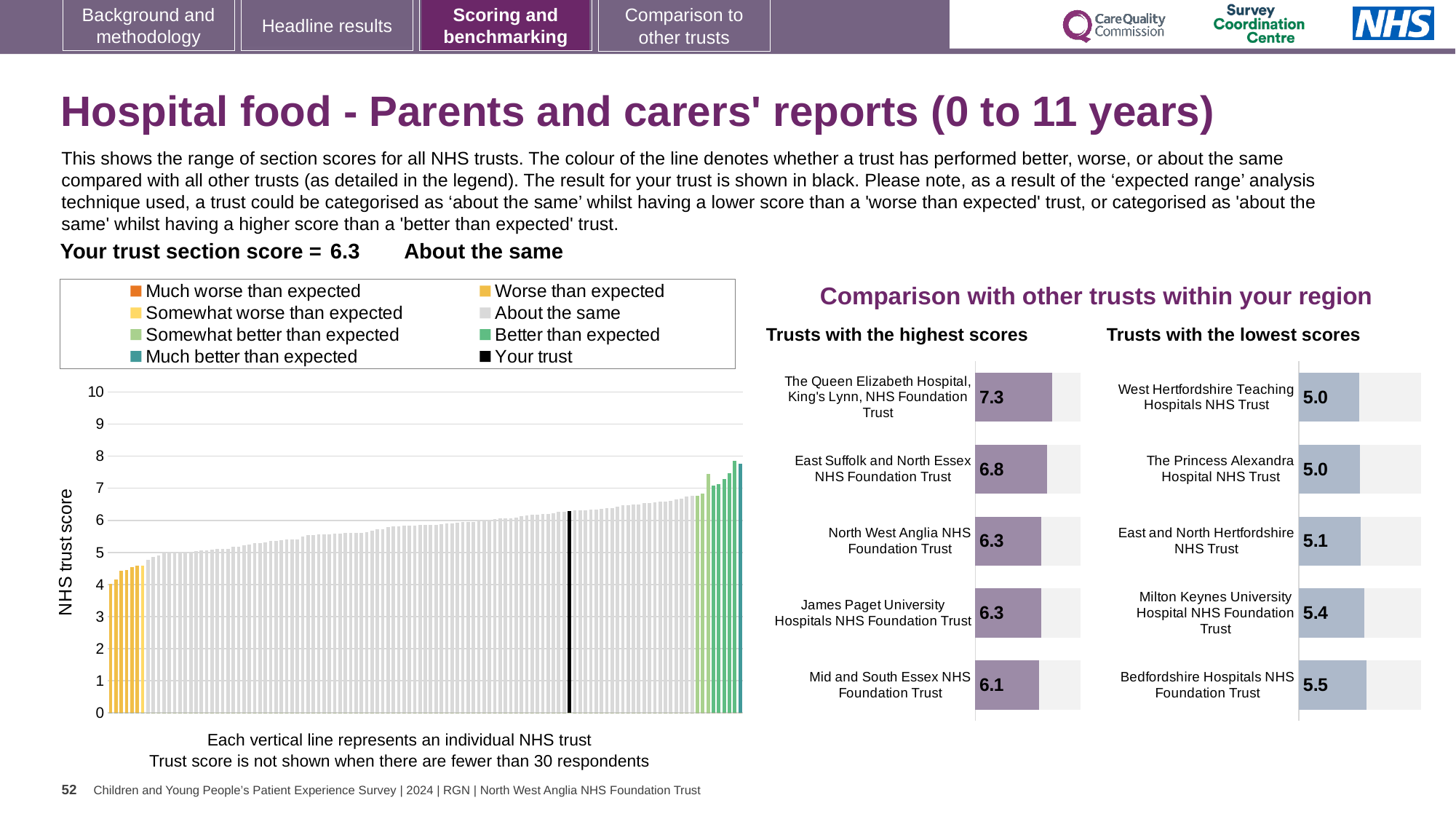
In the 'Trusts with the highest scores' chart, which trust has the lowest score? Mid and South Essex NHS Foundation Trust In the 'Trusts with the highest scores' chart, what is the difference between the scores of The Queen Elizabeth Hospital, King's Lynn, NHS Foundation Trust and East Suffolk and North Essex NHS Foundation Trust? 0.5 In the 'Trusts with the highest scores' chart, what is the score for The Queen Elizabeth Hospital, King's Lynn, NHS Foundation Trust? 7.3 In the large chart on the left, is the value of the black bar (your trust) greater or less than 5? greater How many trusts are shown in the 'Trusts with the lowest scores' chart? 5 In the large chart on the left, what is the label on the vertical axis? NHS trust score What kind of chart is the large chart on the left showing all NHS trusts? bar chart In the 'Trusts with the lowest scores' chart, what is the score for Milton Keynes University Hospital NHS Foundation Trust? 5.4 How many entries does the legend above the large chart on the left list? 8 In the 'Trusts with the lowest scores' chart, which trust has the highest score? Bedfordshire Hospitals NHS Foundation Trust In the 'Trusts with the lowest scores' chart, which has the larger score: East and North Hertfordshire NHS Trust or Bedfordshire Hospitals NHS Foundation Trust? Bedfordshire Hospitals NHS Foundation Trust In the large chart on the left, is the value of the leftmost (lowest) bar greater or less than 5? less